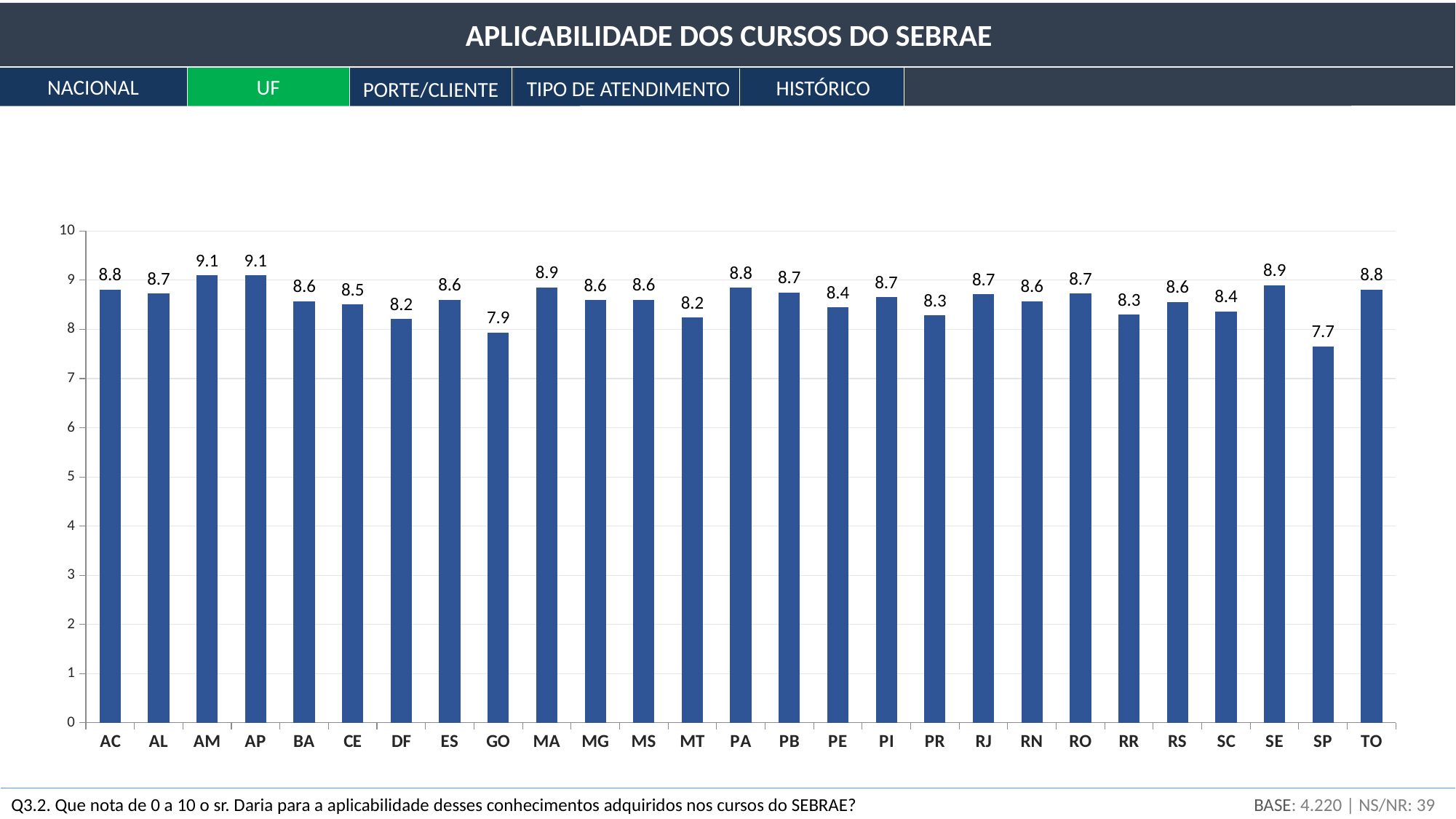
What is the value for GO? 7.9 What is the title of the slide? APLICABILIDADE DOS CURSOS DO SEBRAE What is the value for SP? 7.7 Is the value for GO greater or less than 8? less What is the value for MA? 8.9 What is the value for PE? 8.4 What is the difference between the values for SE and DF? 0.7 Which is larger, the value for PA or the value for PR? PA What kind of chart is shown on the slide? bar chart Which state has the lowest value? SP What is the difference between the values for AM and SP? 1.4 How many states are shown on the x axis? 27